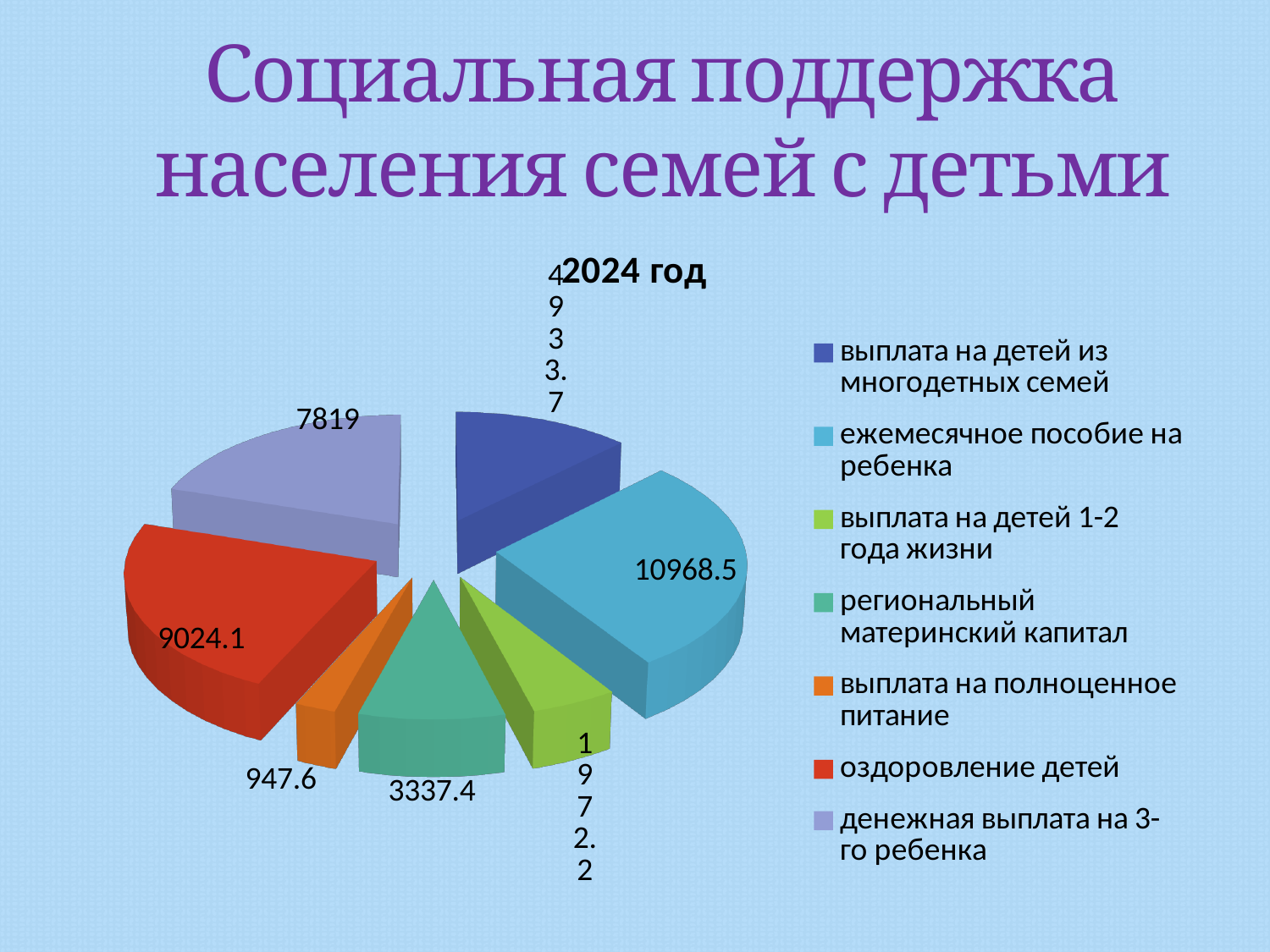
What type of chart is shown on the slide? pie chart What is the title of the chart? 2024 год Which category has the smallest slice? выплата на полноценное питание What is the value for 'ежемесячное пособие на ребенка'? 10968.5 What is the value for 'региональный материнский капитал'? 3337.4 What is the value for 'выплата на полноценное питание'? 947.6 What is the difference between the values for 'ежемесячное пособие на ребенка' and 'оздоровление детей'? 1944.4 Which category has the largest slice? ежемесячное пособие на ребенка What is the value for 'оздоровление детей'? 9024.1 What is the value for 'денежная выплата на 3-го ребенка'? 7819 How many entries does the legend list? 7 How many slices does the pie chart have? 7